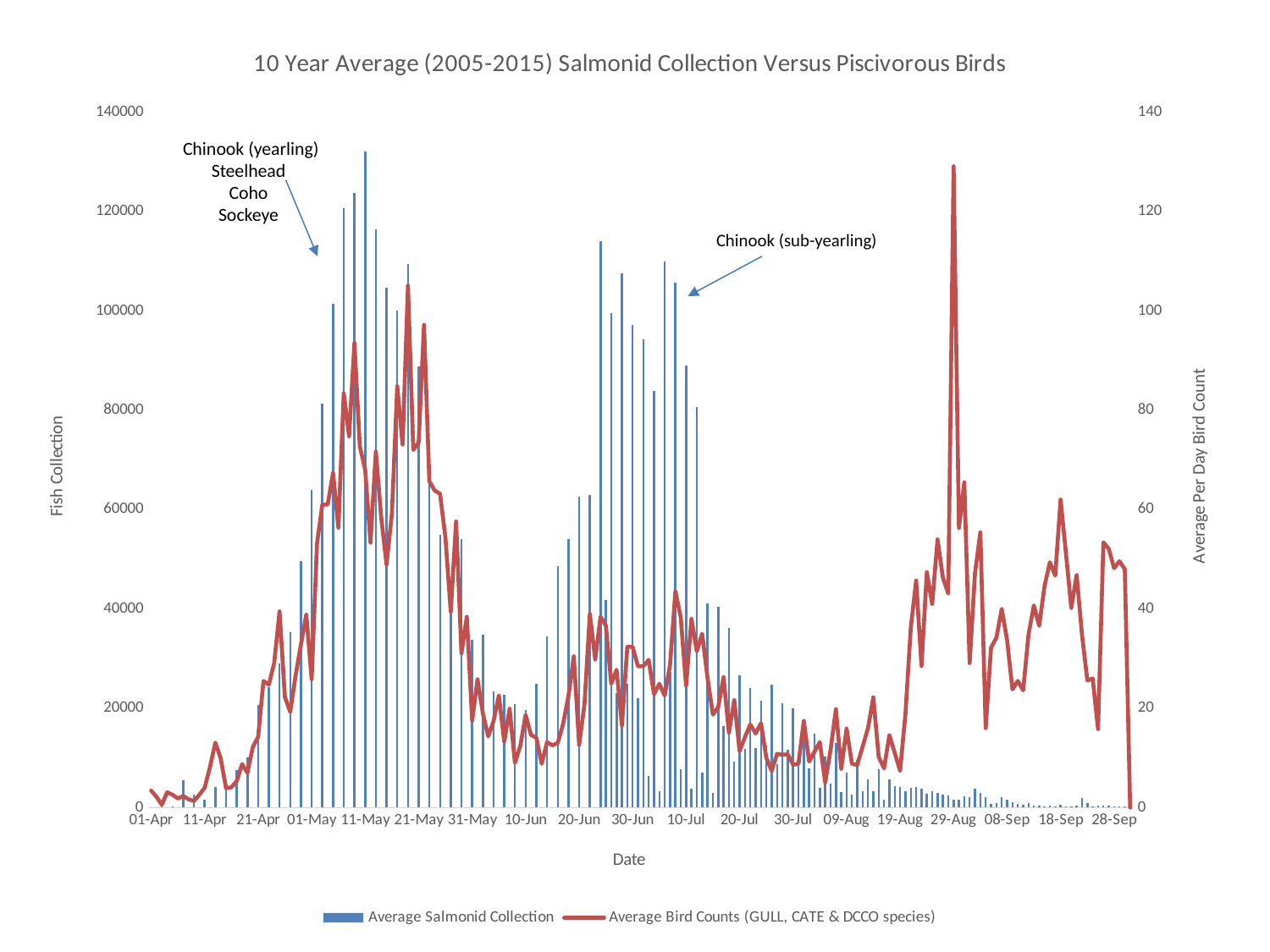
Is the Average Bird Counts value on 01-Apr greater or less than 20? less What is the title of the chart? 10 Year Average (2005-2015) Salmonid Collection Versus Piscivorous Birds Which is larger, the Average Salmonid Collection near 11-May or near 20-Jul? Near 11-May Is the Average Salmonid Collection value on 28-Sep greater or less than 20000? less Which series is drawn as a red line? Average Bird Counts (GULL, CATE & DCCO species) Is the tallest Average Salmonid Collection bar, near 11-May, greater or less than 120000? greater How many series does the legend list? 2 Does the Average Bird Counts line rise or fall between 19-Aug and 29-Aug? Rise Around which date does the Average Bird Counts line reach its highest peak? 29-Aug What kind of chart is this? Combined bar and line chart Around which date does the Average Salmonid Collection reach its highest bar? 11-May